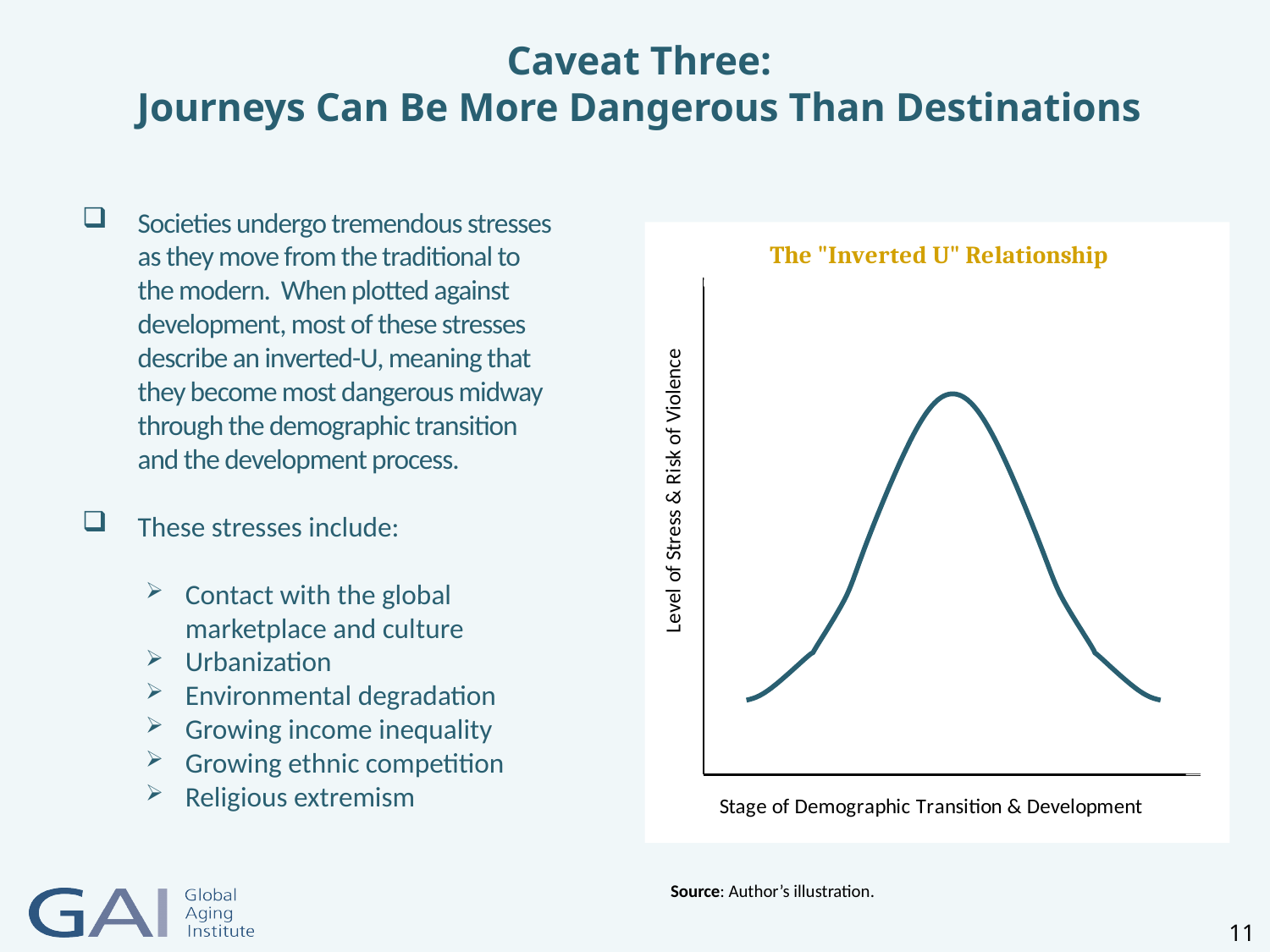
Does the plotted line rise or fall along the second half of the x axis? Falls What is the label on the vertical axis of the chart? Level of Stress & Risk of Violence Overall, what shape does the plotted line describe across the x axis? An inverted U How many lines are plotted on the chart? 1 Where along the x axis does the plotted line reach its highest point: near the left end, in the middle, or near the right end? In the middle Does the plotted line rise or fall along the first half of the x axis? Rises Is the value at the left end of the line higher or lower than the value at the middle of the line? Lower What is the title of the chart? The "Inverted U" Relationship What kind of chart is shown on the slide? Line chart